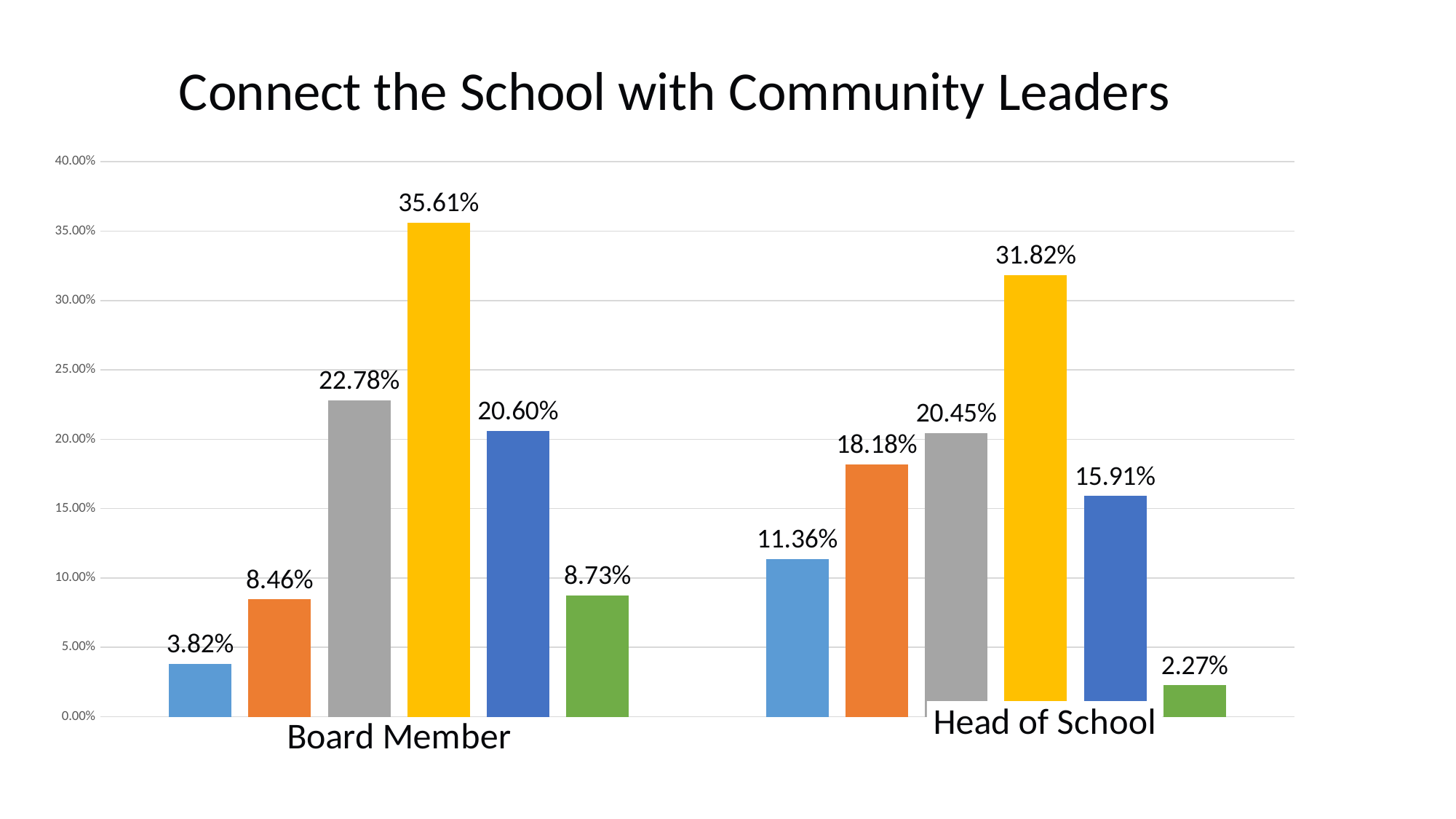
What is the value of the yellow bar for Board Member? 35.61% What is the value of the orange bar for Head of School? 18.18% What is the value of the light blue bar for Board Member? 3.82% What is the value of the green bar for Head of School? 2.27% What kind of chart is shown on the slide? bar chart Which bar has the lowest value in the Head of School group? the green bar (2.27%) Is the value of the dark blue bar for Head of School greater or less than 20.00%? less Which bar has the highest value in the Board Member group? the yellow bar (35.61%) What is the difference between the yellow bar for Board Member and the yellow bar for Head of School? 3.79% Which is larger: the gray bar for Board Member or the gray bar for Head of School? the gray bar for Board Member (22.78%) What is the title of the chart? Connect the School with Community Leaders How many categories are shown on the x axis? 2